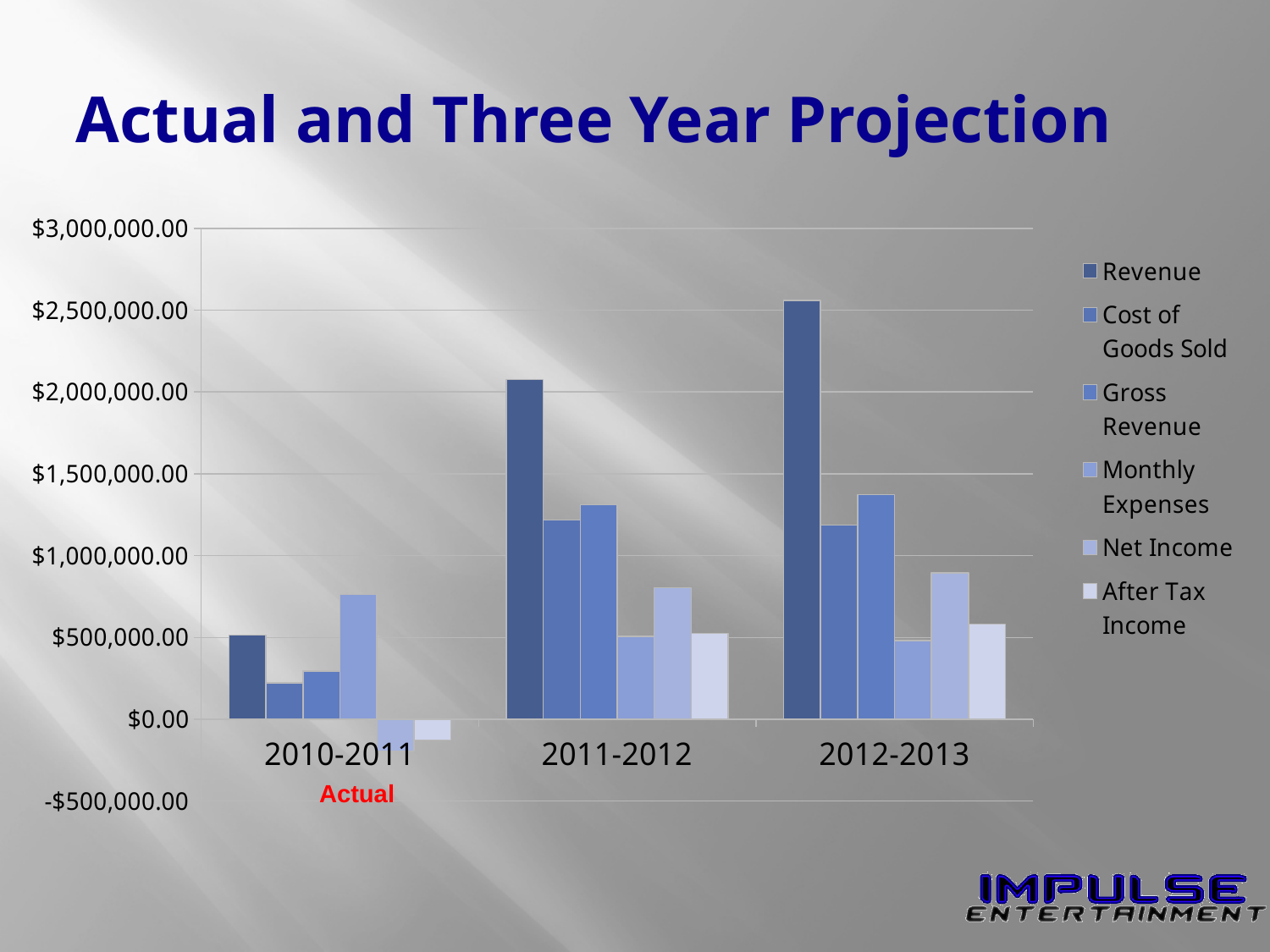
Which year has the highest Revenue bar? 2012-2013 Which year category is labelled "Actual" beneath the x axis? 2010-2011 In 2011-2012, which is larger: Revenue or Cost of Goods Sold? Revenue Is the Net Income value for 2010-2011 greater or less than $0.00? less Is the Gross Revenue value for 2012-2013 greater or less than $1,500,000.00? less Is the Monthly Expenses value for 2010-2011 greater or less than $500,000.00? greater What kind of chart is shown on the slide? bar chart How many series does the legend list? 6 Does Revenue rise or fall from 2010-2011 to 2012-2013? rise Which year has the lowest Revenue bar? 2010-2011 How many year categories are shown on the x axis? 3